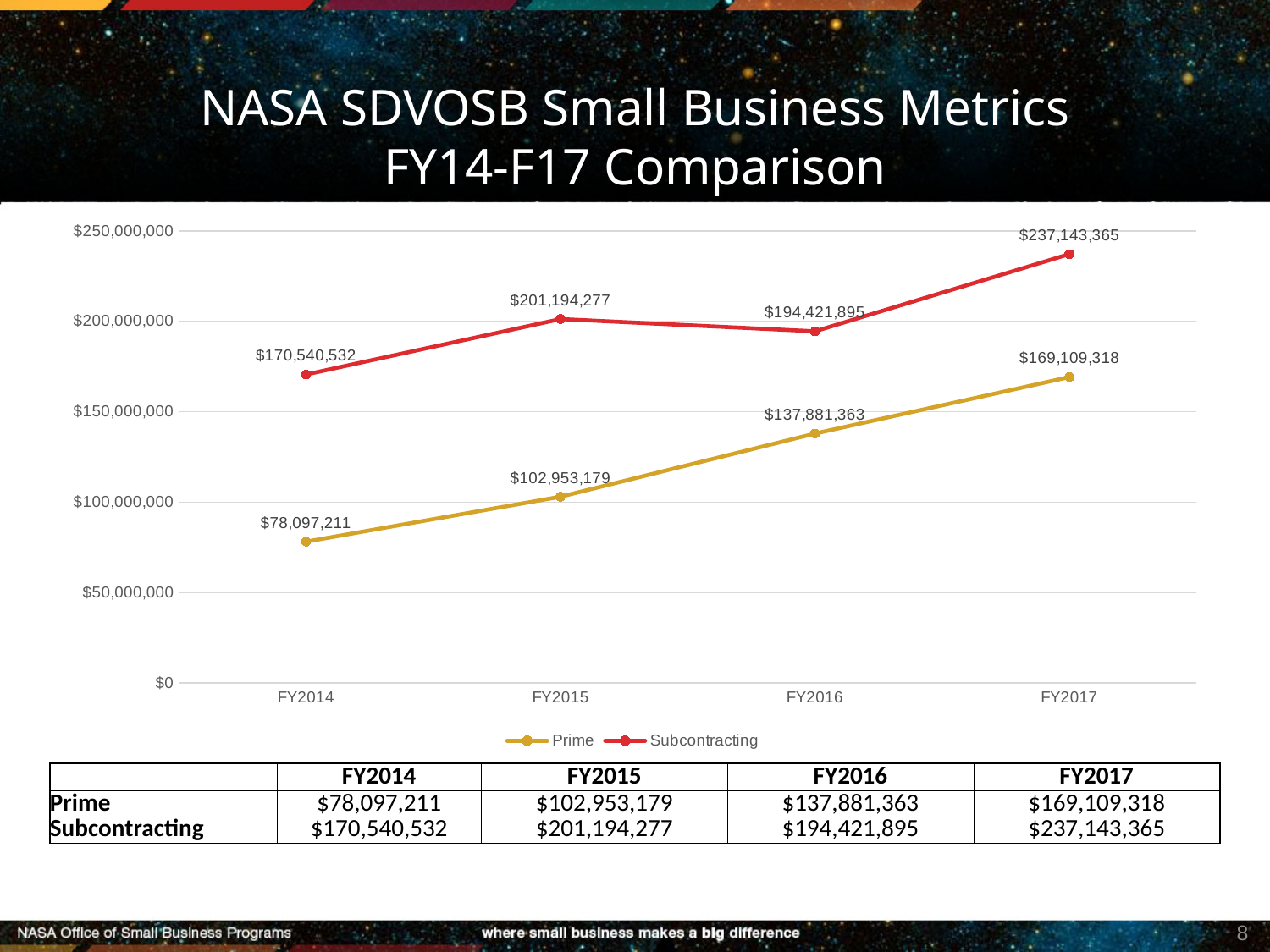
What type of chart is shown on the slide? Line chart In which fiscal year is the Prime value lowest? FY2014 What is the Subcontracting value for FY2016? $194,421,895 What is the Prime value for FY2017? $169,109,318 What is the Prime value for FY2014? $78,097,211 How many series does the legend list? 2 Which is larger in FY2015, the Prime value or the Subcontracting value? Subcontracting Which colour is used for the Subcontracting line? Red What is the difference between the Subcontracting and Prime values in FY2017? $68,034,047 How many fiscal years are plotted on the x axis? 4 Does the Prime series rise or fall from FY2014 to FY2017? Rise In which fiscal year is the Subcontracting value highest? FY2017